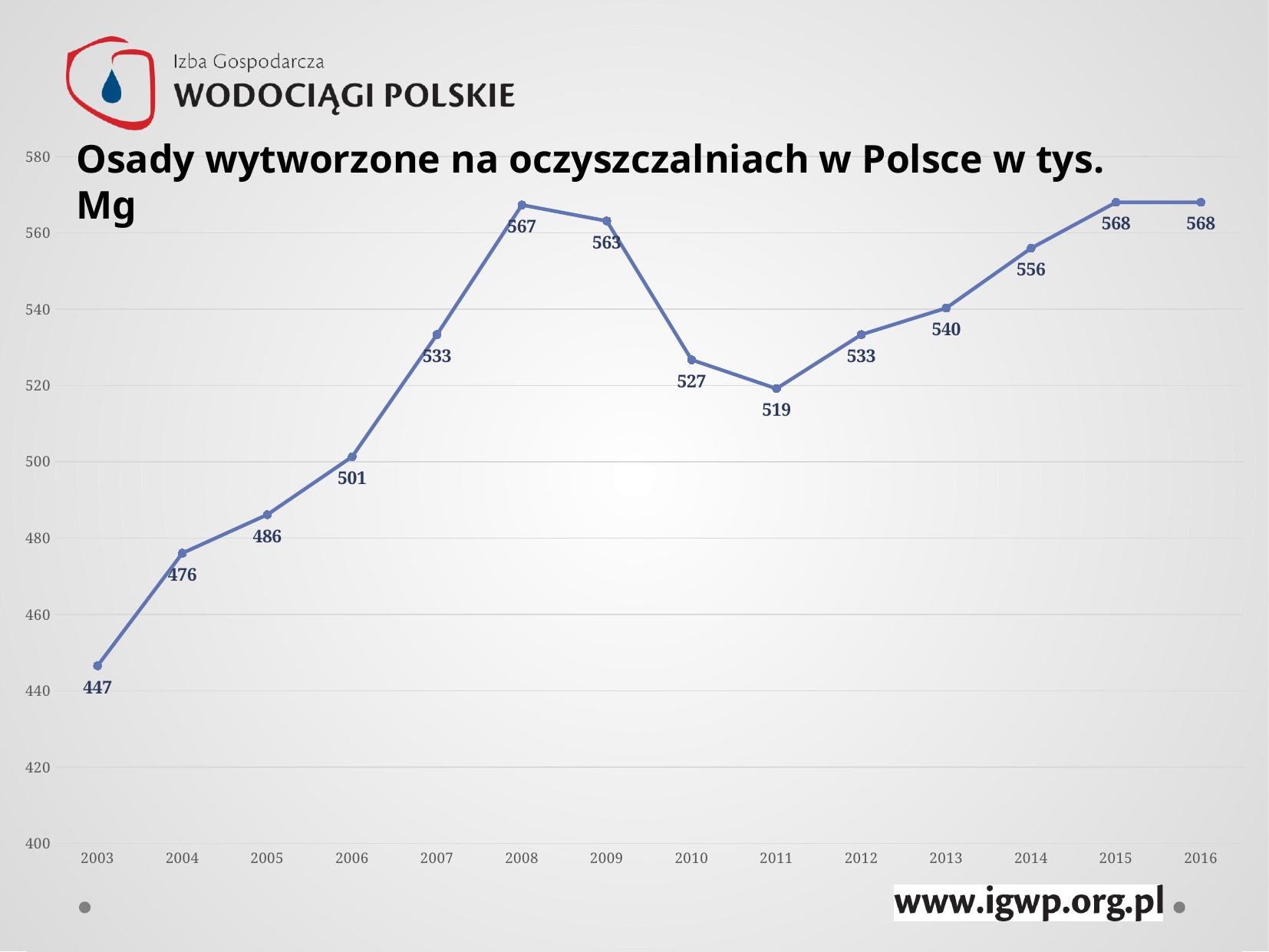
What is the difference between the values for 2016 and 2003? 121 Do the values rise or fall from 2011 to 2015? rise Which is larger, the value for 2009 or the value for 2014? 2009 What value is shown for 2003? 447 What kind of chart is shown on the slide? line chart What is the difference between the values for 2008 and 2011? 48 What value is shown for 2011? 519 What is the highest value plotted on the chart? 568 What value is shown for 2008? 567 Which year has the lowest value? 2003 How many years are plotted on the chart? 14 Is the value for 2010 greater or less than 540? less